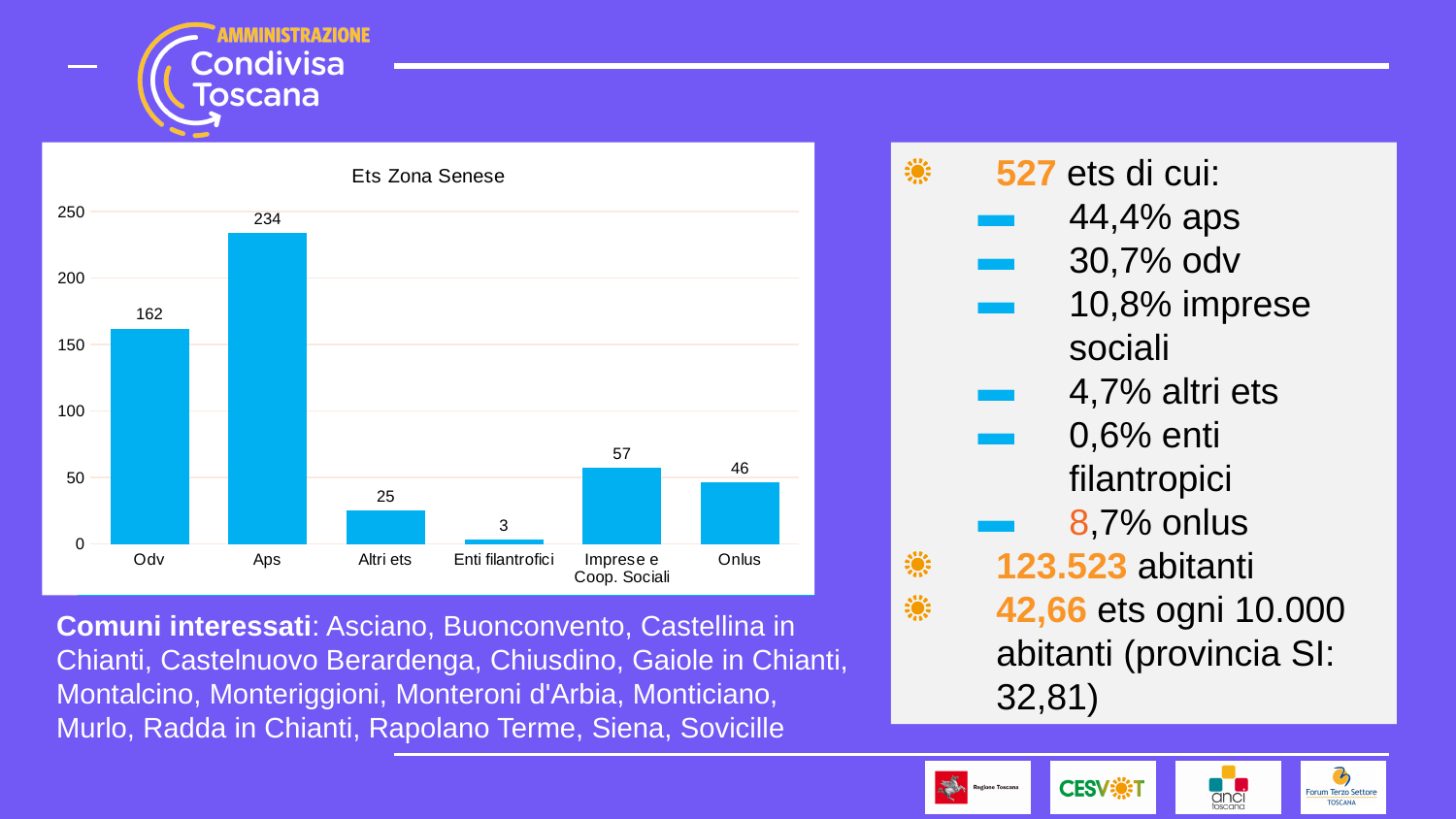
What kind of chart is the Ets Zona Senese chart? bar chart What is the title of the chart on the slide? Ets Zona Senese Which category has the highest value in the Ets Zona Senese chart? Aps Which category has the lowest value in the Ets Zona Senese chart? Enti filantrofici What is the value for Imprese e Coop. Sociali in the Ets Zona Senese chart? 57 What is the difference between the values for Aps and Odv in the Ets Zona Senese chart? 72 How many categories are shown in the Ets Zona Senese chart? 6 Is the value for Altri ets in the Ets Zona Senese chart greater or less than 50? less What is the value for Aps in the Ets Zona Senese chart? 234 Which is larger in the Ets Zona Senese chart, Imprese e Coop. Sociali or Onlus? Imprese e Coop. Sociali What is the value for Enti filantrofici in the Ets Zona Senese chart? 3 What is the value for Odv in the Ets Zona Senese chart? 162